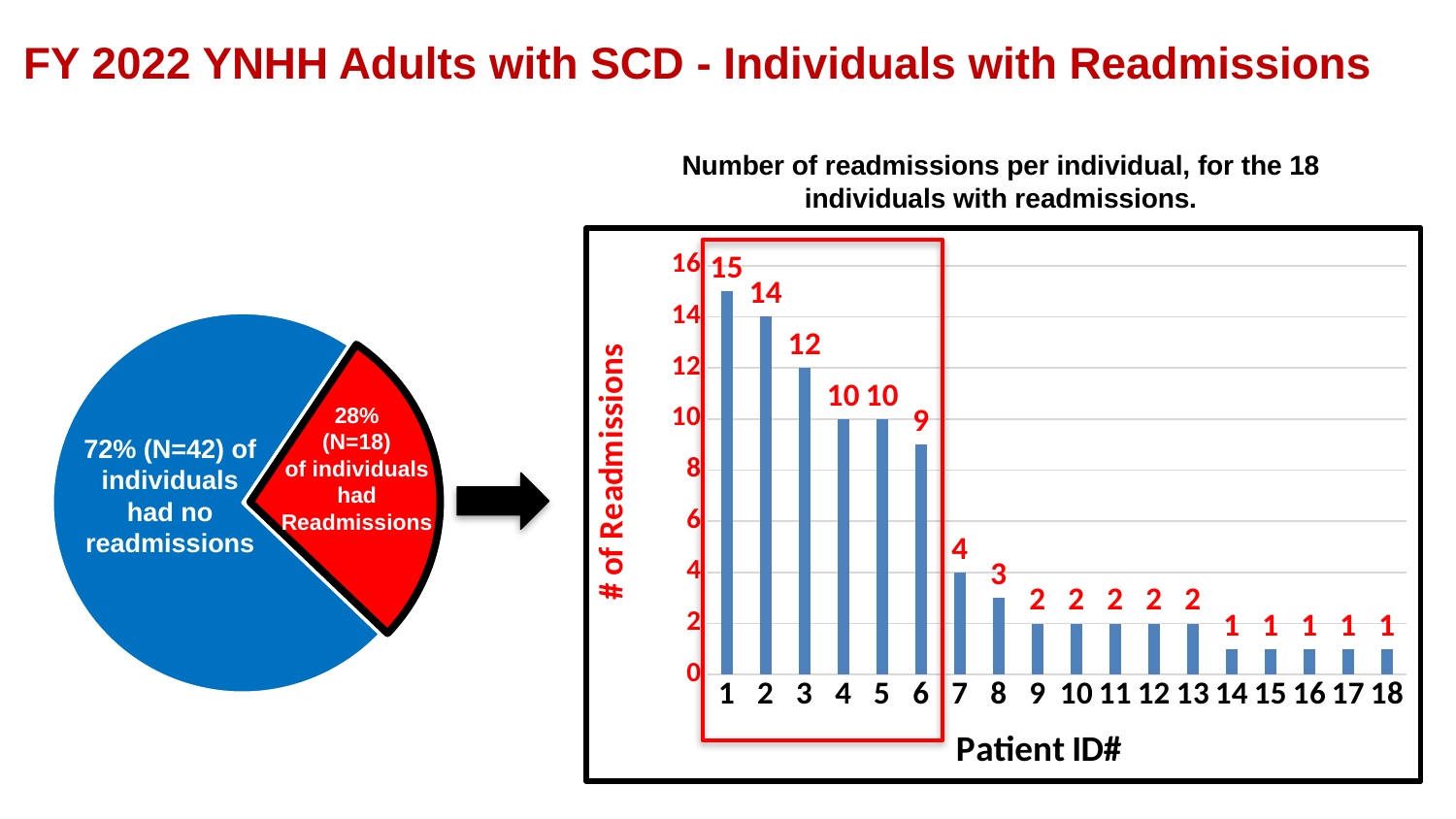
In the bar chart on the right, what is the difference in readmissions between Patient ID# 2 and Patient ID# 7? 10 In the bar chart on the right, do the number of readmissions rise or fall as the Patient ID# increases from 1 to 18? Fall In the pie chart on the left, what share of individuals had readmissions? 28% What kind of chart is the chart on the left of the slide? Pie chart In the bar chart on the right, how many patients are shown on the x axis? 18 In the bar chart on the right, which has more readmissions, Patient ID# 6 or Patient ID# 8? Patient ID# 6 In the bar chart on the right, how many readmissions does Patient ID# 3 have? 12 In the bar chart on the right, what is the label of the y axis? # of Readmissions In the pie chart on the left, how many individuals (N) had no readmissions? 42 In the bar chart on the right, which Patient ID# has the highest number of readmissions? 1 What kind of chart is the chart on the right of the slide? Bar chart In the bar chart on the right, how many readmissions does Patient ID# 1 have? 15